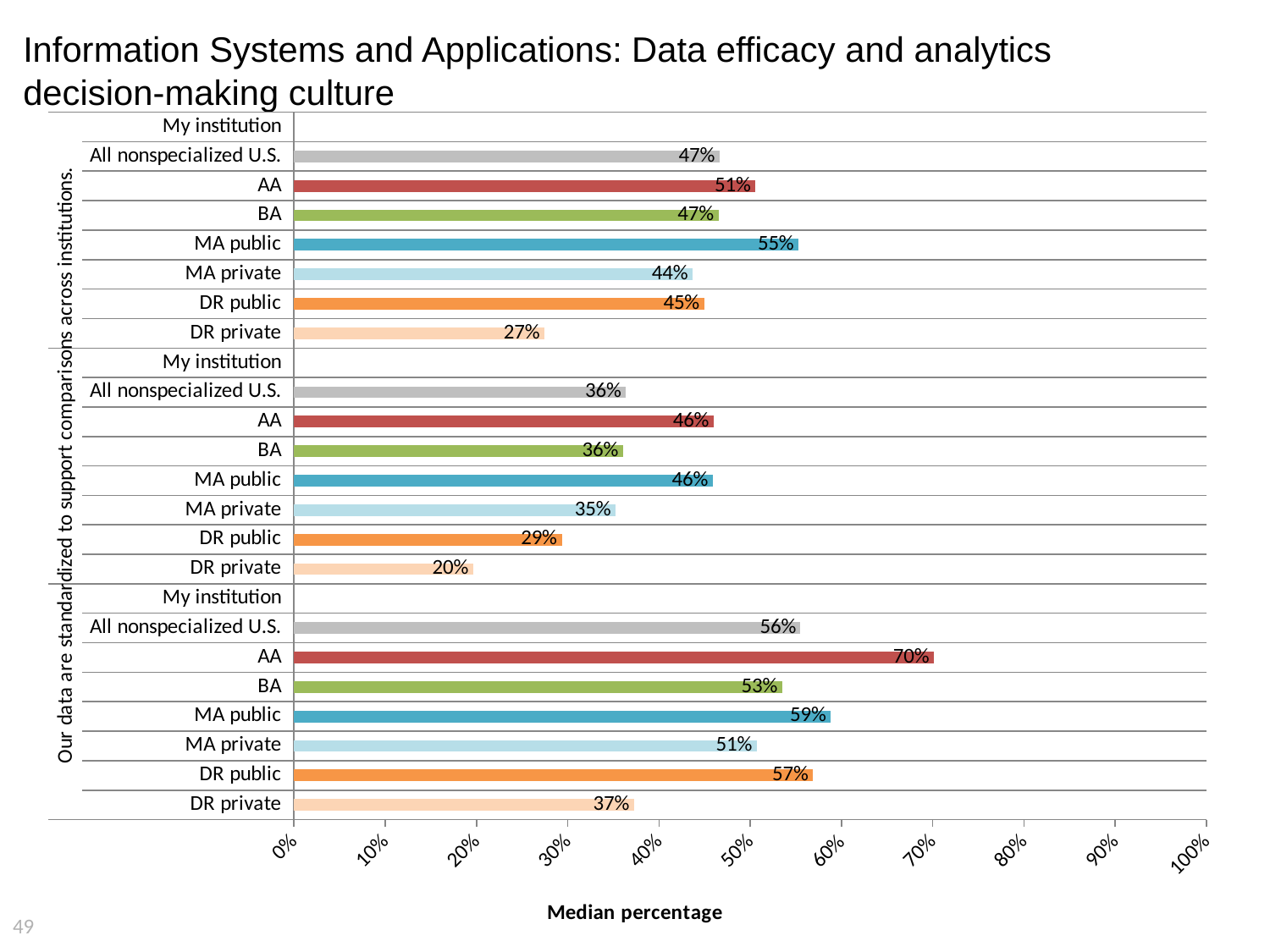
In the bottom group of bars, which is larger: the value for MA public or the value for DR public? MA public In the bottom group of bars, which category has the highest value? AA In the top group of bars, which category has the lowest value? DR private In the bottom group of bars, what is the value for AA? 70% What is the title of the horizontal axis? Median percentage In the top group of bars, what is the value for MA public? 55% In the middle group of bars, what is the difference between the AA value and the DR public value? 17% What type of chart is shown on the slide? Bar chart In the bottom group of bars, what is the difference between the All nonspecialized U.S. value and the DR private value? 19% How many labeled bars with values are shown in the bottom group? 7 In the middle group of bars, what is the value for DR private? 20% In the top group of bars, is the value for DR private greater or less than 30%? less